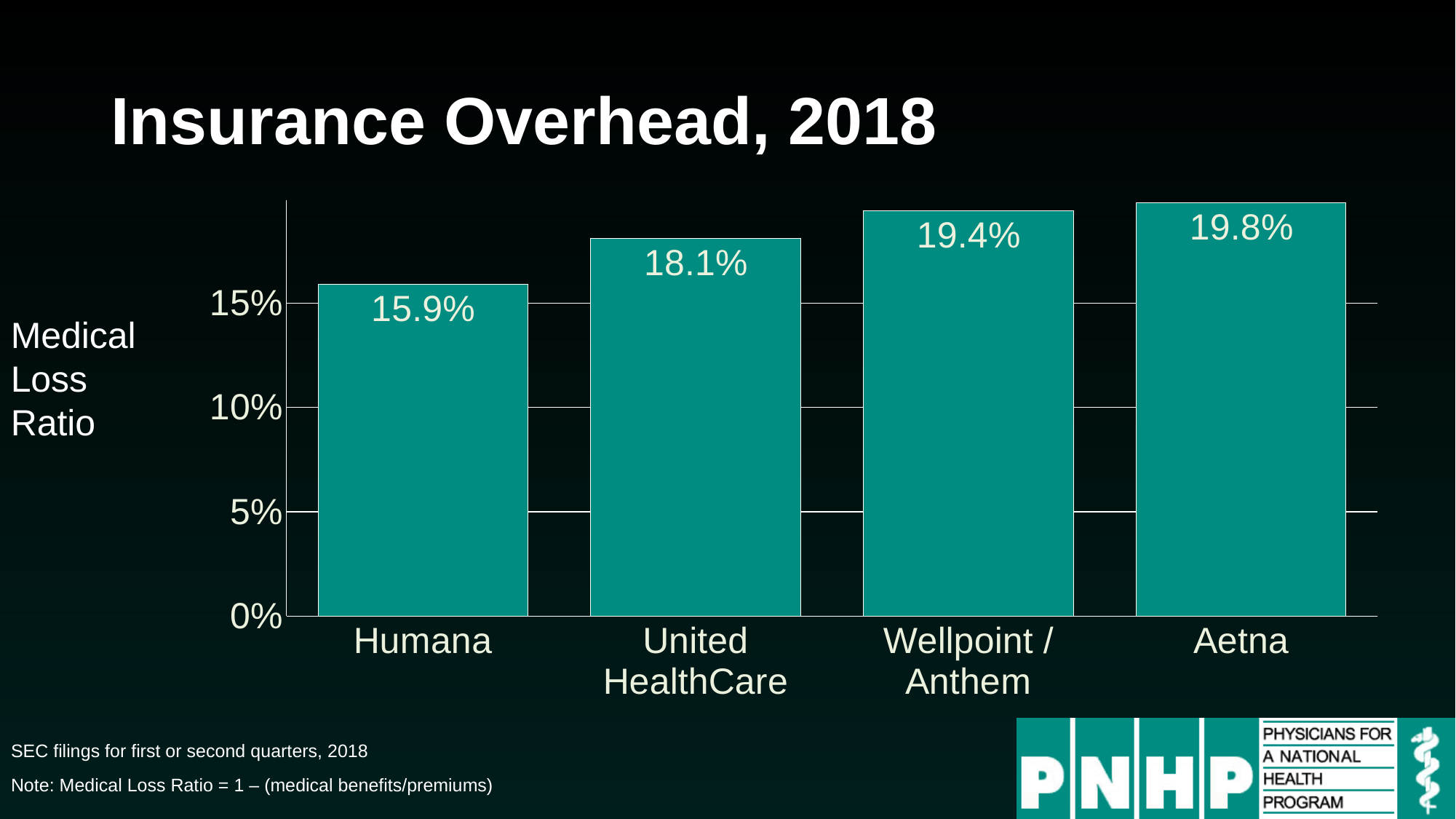
What is the value for Aetna? 19.8% Which insurer has the lowest value? Humana What is the value for Humana? 15.9% Which is larger, the value for United HealthCare or the value for Humana? United HealthCare What is the value for United HealthCare? 18.1% What kind of chart is shown on the slide? bar chart How many insurers are shown in the chart? 4 Is the value for Humana greater or less than 15%? greater Which insurer has the highest value? Aetna What is the title of the chart? Insurance Overhead, 2018 What is the value for Wellpoint / Anthem? 19.4% What is the difference between the values for Aetna and Humana? 3.9%